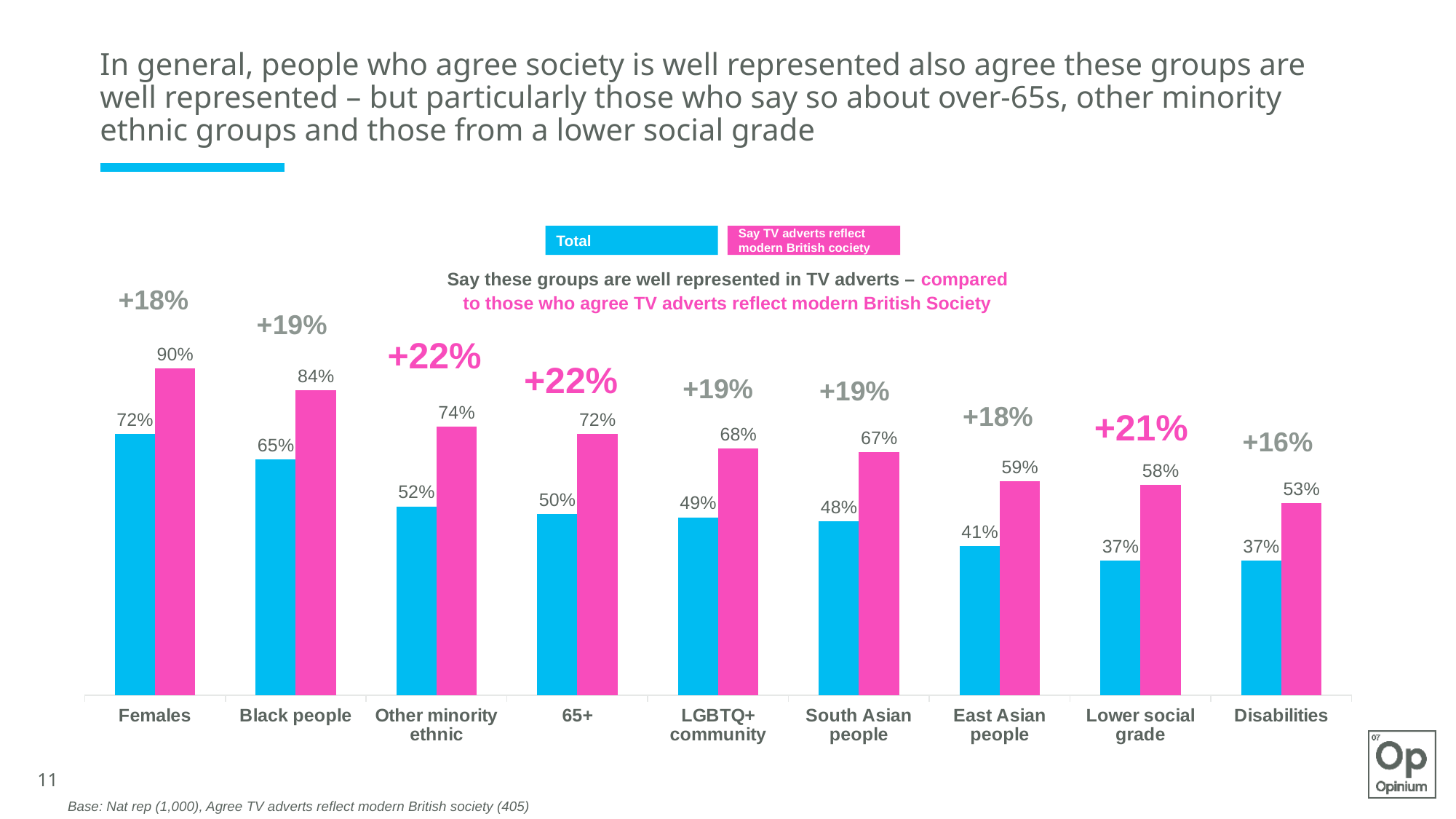
Which is larger: the Total value for 65+ or the Total value for LGBTQ+ community? 65+ What is the Total value for East Asian people? 41% How many series does the legend list? 2 What is the Total value for Females? 72% What colour are the bars for the Total series? Blue What is the difference between the two series for Other minority ethnic? 22% What is the value for Black people among those who say TV adverts reflect modern British society? 84% Do the Total values generally rise or fall from left to right across the categories? Fall What kind of chart is shown on the slide? Bar chart Which category has the lowest Total value? Lower social grade and Disabilities (both 37%) Which category has the highest value in the 'Say TV adverts reflect modern British society' series? Females How many categories are shown on the x axis? 9